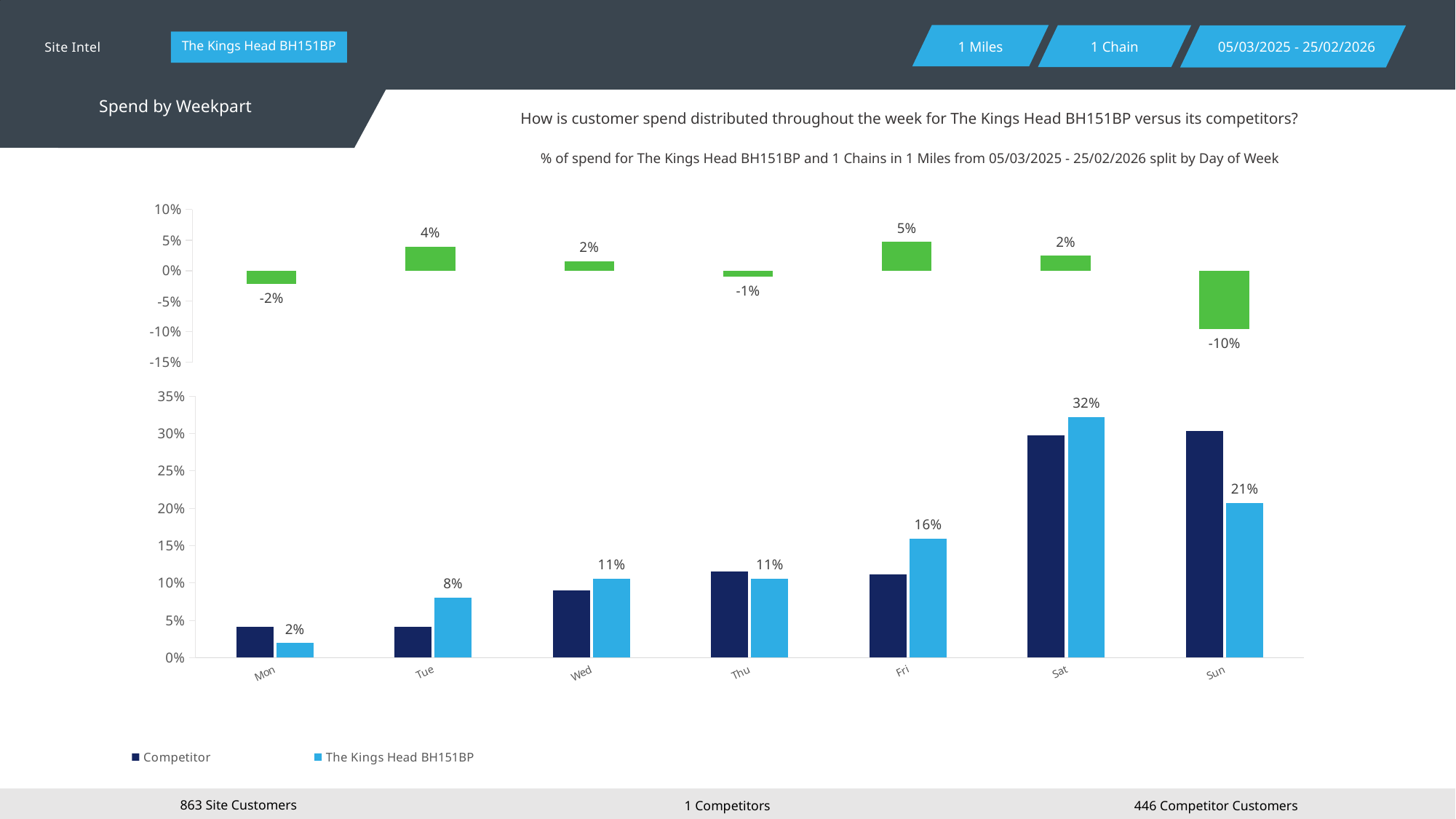
In the bottom chart, on which day is The Kings Head BH151BP value highest? Sat In the bottom chart, which is larger on Sun: the Competitor value or The Kings Head BH151BP value? Competitor In the top chart, which day has the highest value? Fri In the top chart, what is the value for Sun? -10% How many series does the legend of the bottom chart list? 2 In the bottom chart, what is the difference between The Kings Head BH151BP values for Sat and Sun? 11% In the bottom chart, what is the value for The Kings Head BH151BP on Sat? 32% In the bottom chart, is the Competitor value for Sun greater or less than 25%? greater In the bottom chart, on which day is The Kings Head BH151BP value lowest? Mon How many days of the week are shown on the x axis of the bottom chart? 7 What kind of chart is the bottom chart? bar chart In the bottom chart, what is the value for The Kings Head BH151BP on Fri? 16%